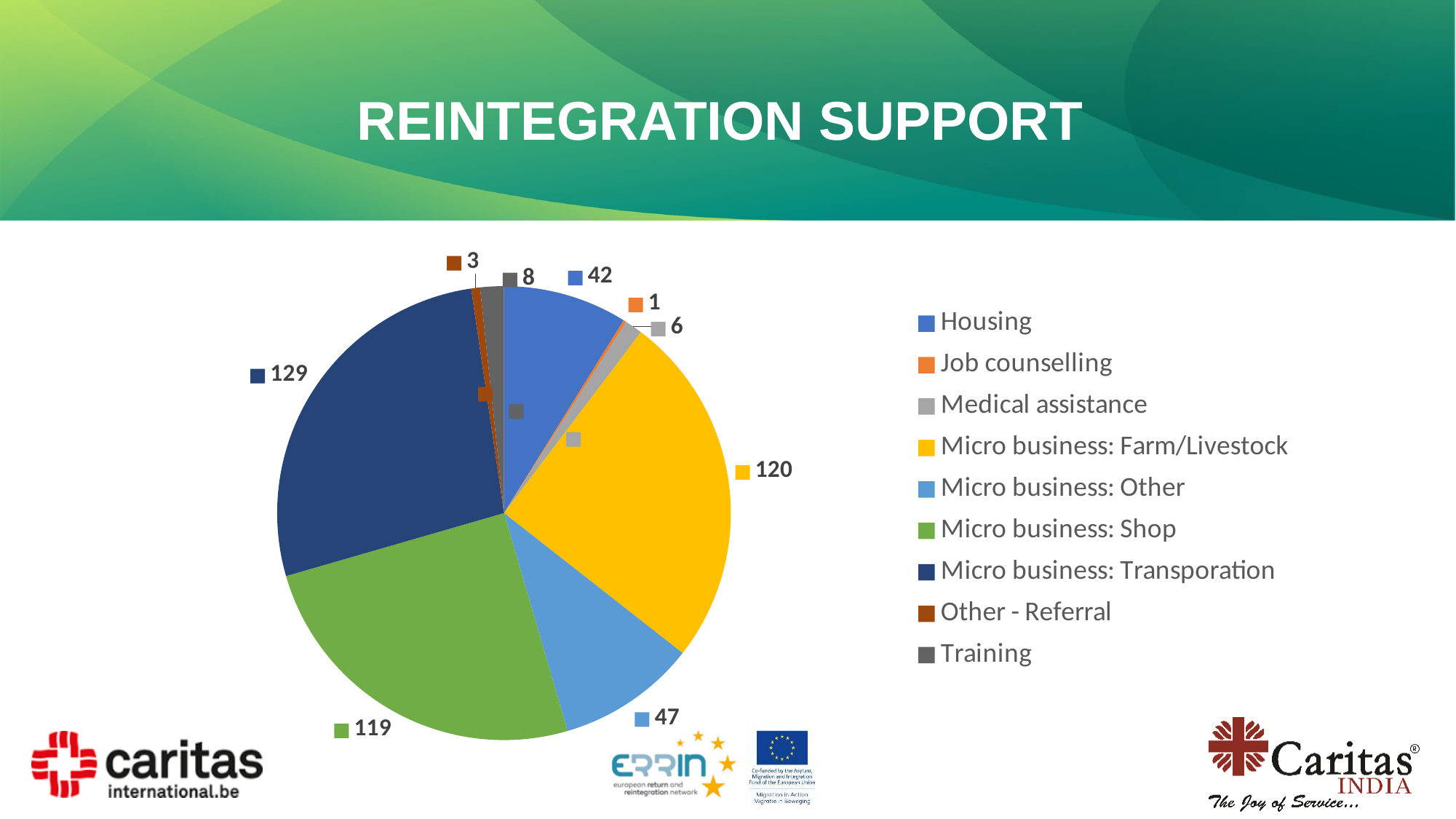
What is the difference between Micro business: Farm/Livestock and Micro business: Other? 73 What is the difference between Micro business: Transporation and Micro business: Shop? 10 What is the title of the slide containing the chart? REINTEGRATION SUPPORT What is the value for Micro business: Farm/Livestock? 120 Which category has the largest slice of the pie? Micro business: Transporation What is the value for Training? 8 Which category has the smallest value? Job counselling What is the value for Other - Referral? 3 Which is larger, Housing or Micro business: Other? Micro business: Other How many categories does the pie chart show? 9 What kind of chart is shown on the slide? Pie chart What is the value for Housing in the pie chart? 42